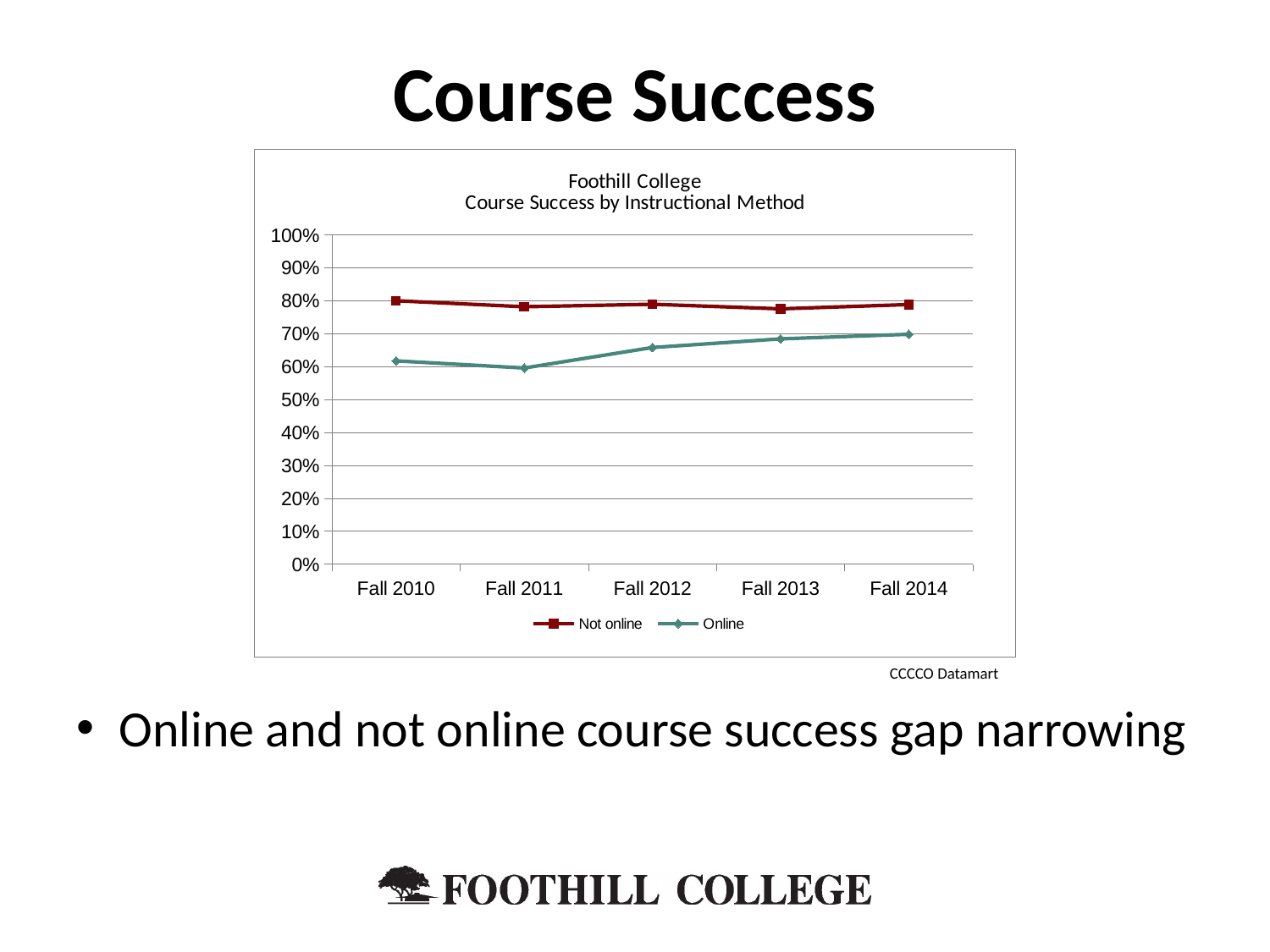
What kind of chart is shown on the slide? Line chart How many series does the chart's legend list? 2 Does the Online course success rate rise or fall from Fall 2011 to Fall 2014? Rise How many terms are plotted along the x axis of the chart? 5 What data source is cited below the chart? CCCCO Datamart In which term is the Online course success rate highest? Fall 2014 Which series has the higher course success rate in Fall 2010, Not online or Online? Not online Is the Not online course success rate for Fall 2013 greater or less than 80%? less Is the Online course success rate for Fall 2013 greater or less than 70%? less In which term is the Online course success rate lowest? Fall 2011 Is the Online course success rate for Fall 2010 greater or less than 60%? greater What is the title of the chart? Foothill College Course Success by Instructional Method